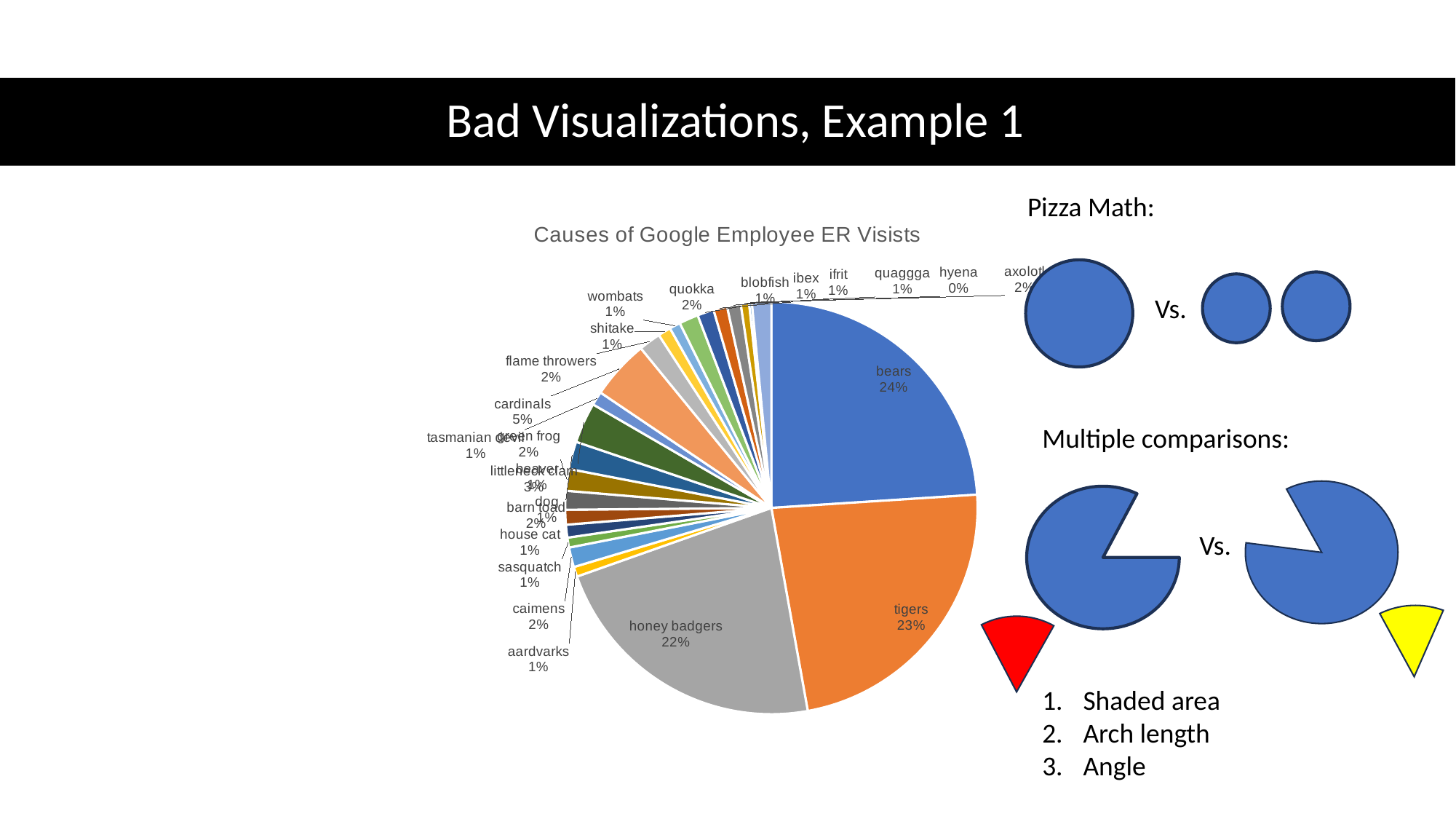
What type of chart is shown on the slide? pie chart What is the difference in percentage points between bears and tigers? 1% What percentage is shown for tigers? 23% Which has a larger share, tigers or honey badgers? tigers What is the difference in percentage points between bears and honey badgers? 2% What percentage is shown for honey badgers? 22% What percentage is shown for flame throwers? 2% What percentage is shown for hyena? 0% What percentage of the pie does the bears slice represent? 24% What percentage is shown for cardinals? 5% Which category has the smallest labelled share of the pie? hyena Which category has the largest slice of the pie? bears